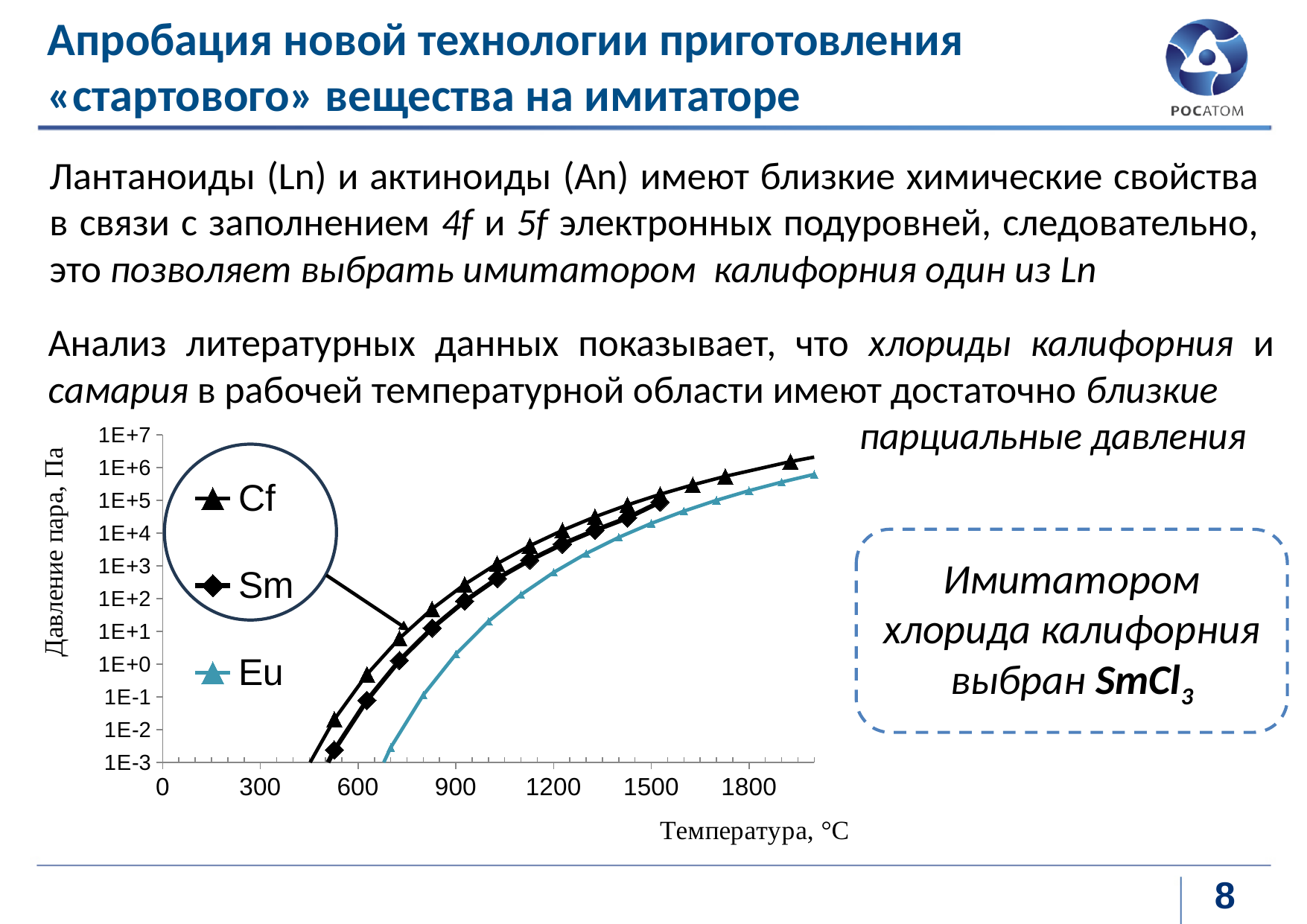
Do the vapour pressure values rise or fall as temperature increases along the x axis? rise Which series has the lowest vapour pressure across the plotted temperature range? Eu Is the vapour pressure of Cf at 600 °C greater or less than 1E+1 Pa? less At 1200 °C, which series has the larger vapour pressure, Sm or Eu? Sm What is the label of the vertical axis of the chart? Давление пара, Па What kind of chart is shown on the slide? line chart How many series does the chart legend list? 3 Is the vapour pressure of Eu at 1500 °C greater or less than 1E+3 Pa? greater Is the vapour pressure of Eu at 1800 °C greater or less than 1E+4 Pa? greater At 900 °C, which series has the larger vapour pressure, Cf or Eu? Cf Which series are listed in the chart legend? Cf, Sm, Eu